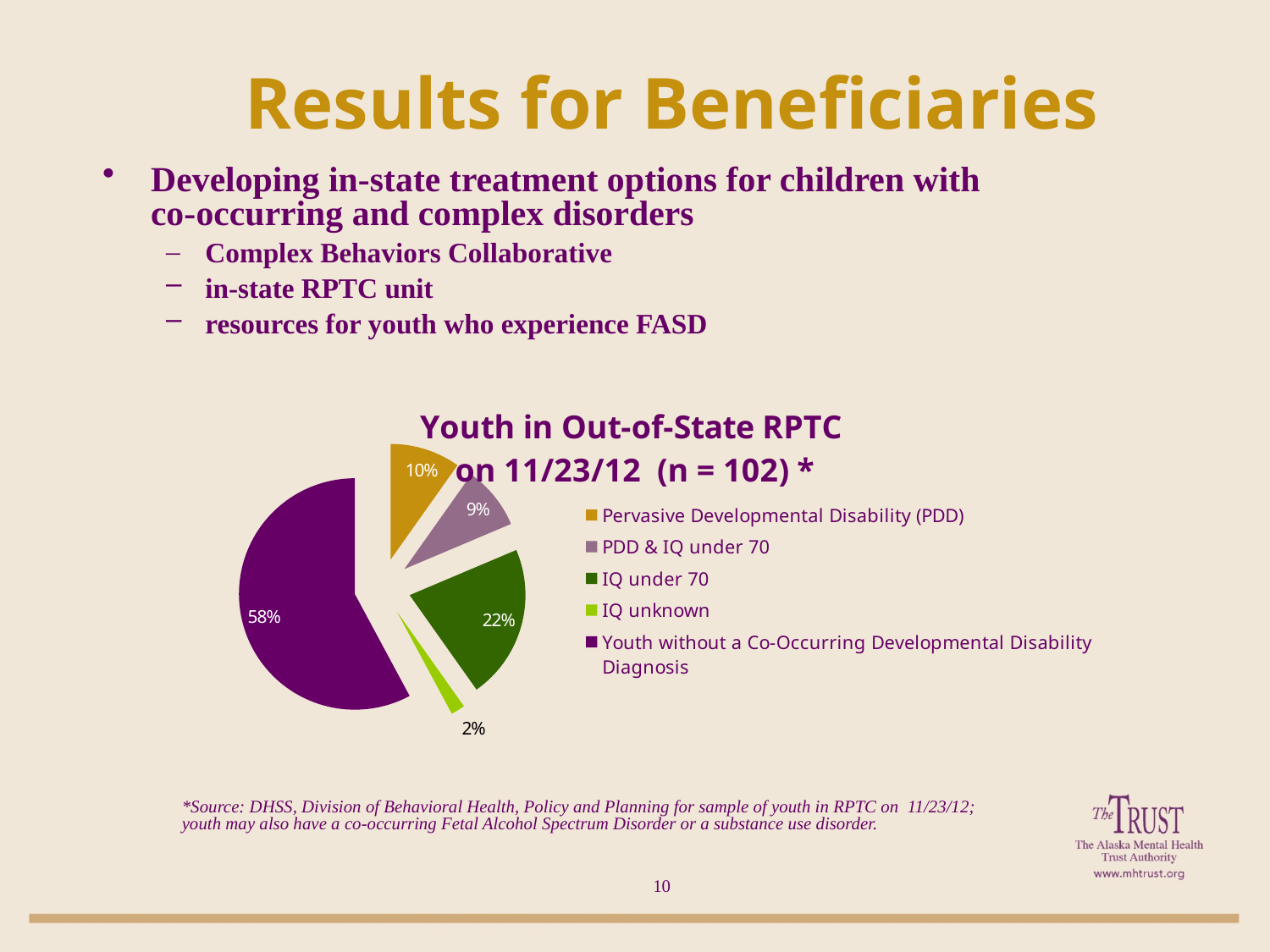
What kind of chart is shown on the slide? Pie chart What percentage of youth in out-of-state RPTC had a Pervasive Developmental Disability (PDD)? 10% How many categories does the pie chart show? 5 What percentage of youth in out-of-state RPTC had IQ under 70? 22% What percentage of youth in out-of-state RPTC had PDD & IQ under 70? 9% Which category makes up the largest share of the pie chart? Youth without a Co-Occurring Developmental Disability Diagnosis Which category makes up the smallest share of the pie chart? IQ unknown What percentage of youth in out-of-state RPTC had IQ unknown? 2% What is the difference in percentage points between the IQ under 70 slice and the PDD slice? 12 What is the sample size (n) stated in the pie chart's title? 102 Which is larger: the share for IQ under 70 or the share for PDD & IQ under 70? IQ under 70 What percentage of youth in out-of-state RPTC were without a co-occurring developmental disability diagnosis? 58%